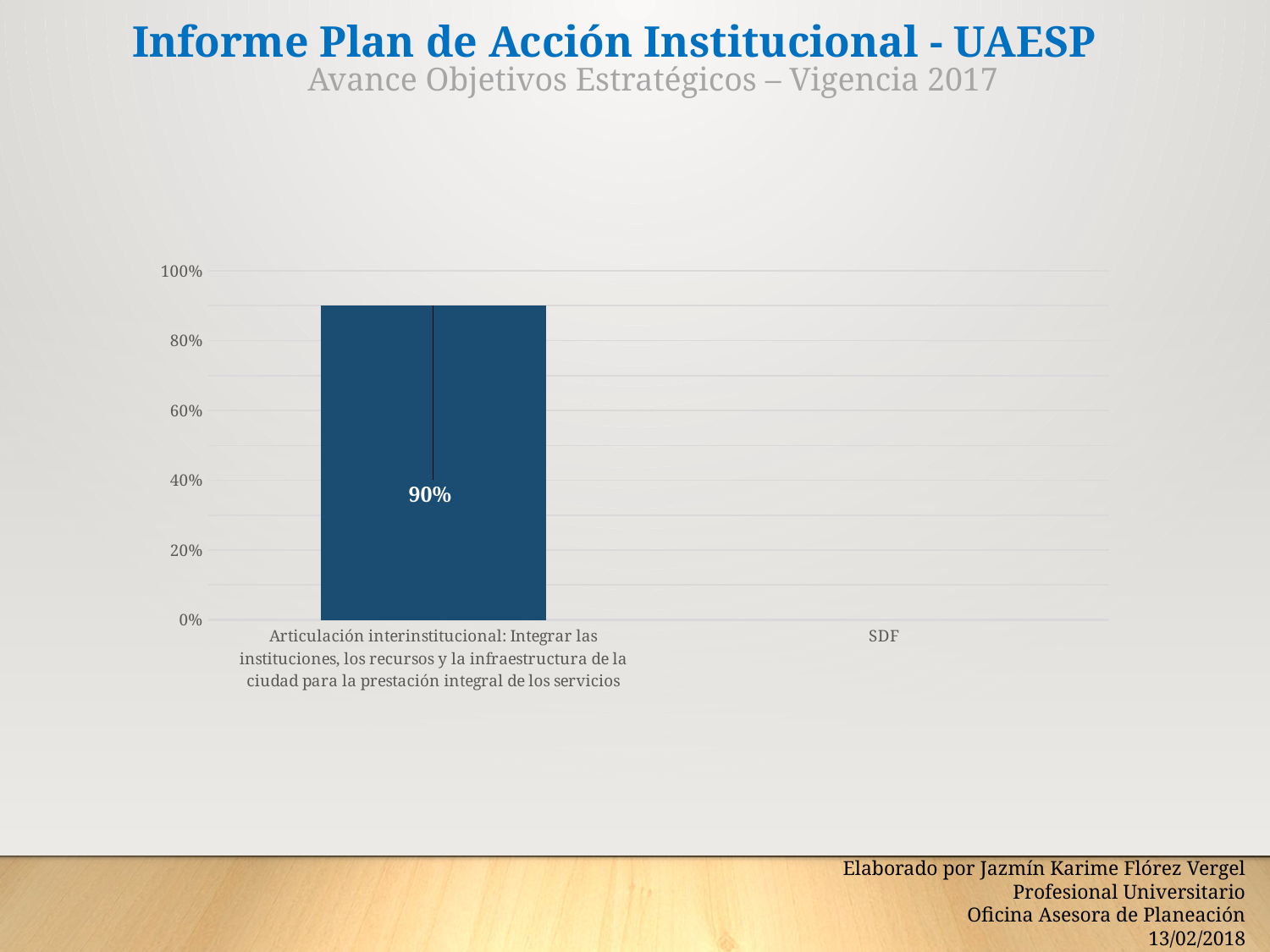
How many categories are shown on the x axis of the chart? 2 What is the highest value shown on the y axis of the chart? 100% Is a visible bar plotted for the category 'SDF'? No Is the value for 'Articulación interinstitucional' greater or less than 80%? greater What kind of chart is shown on the slide? Bar chart Which category has the highest value in the chart? Articulación interinstitucional: Integrar las instituciones, los recursos y la infraestructura de la ciudad para la prestación integral de los servicios What is the value shown for the category 'Articulación interinstitucional: Integrar las instituciones, los recursos y la infraestructura de la ciudad para la prestación integral de los servicios'? 90% Is the value for 'Articulación interinstitucional' greater or less than 100%? less What is the label of the second category on the x axis? SDF